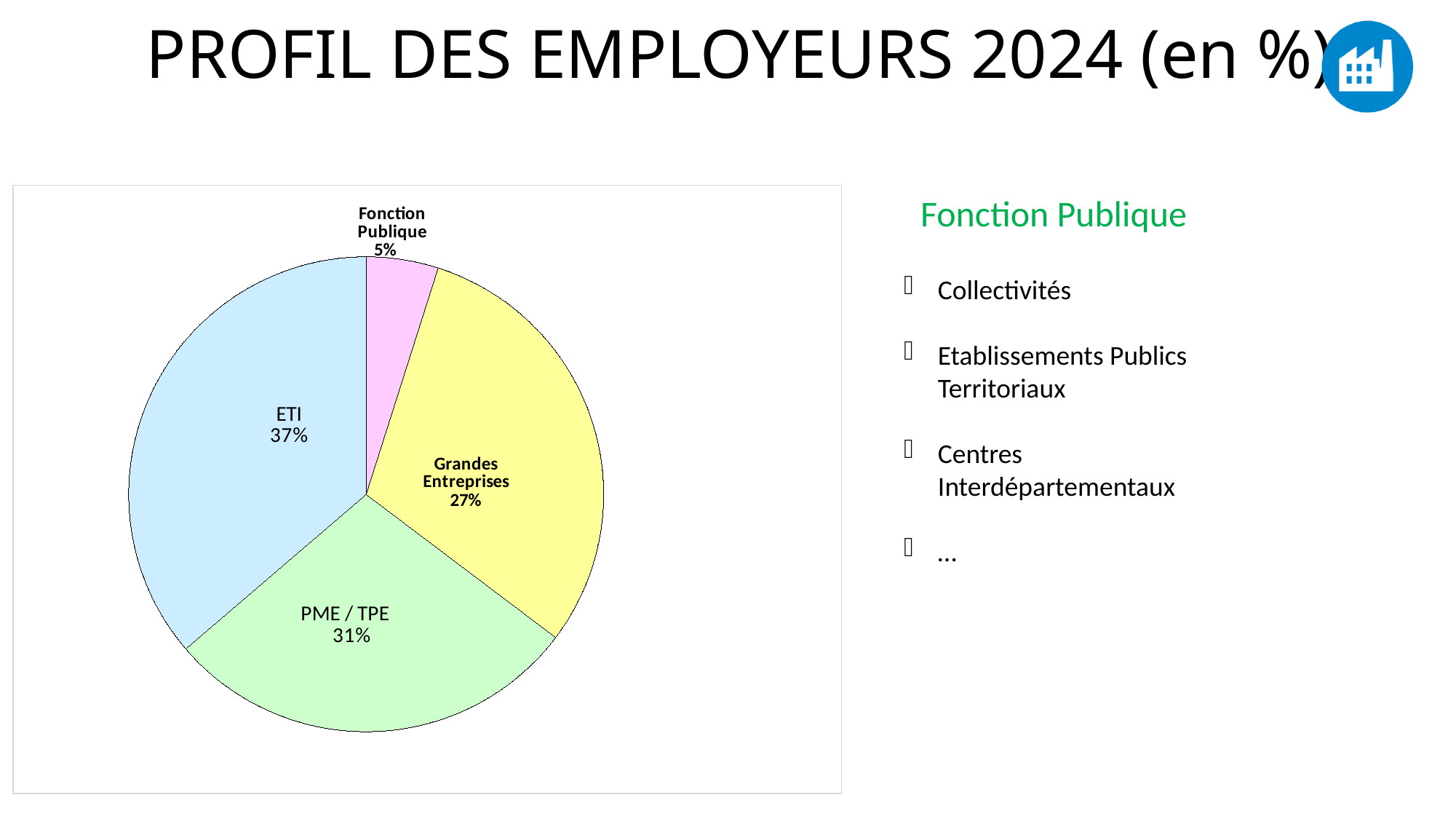
Which category has the largest slice of the pie? ETI How many slices does the pie chart have? 4 What is the difference in percentage points between Grandes Entreprises and Fonction Publique? 22 What share of the pie does PME / TPE represent? 31% What share of the pie does ETI represent? 37% What is the difference in percentage points between ETI and PME / TPE? 6 Which category has the smallest slice of the pie? Fonction Publique What colour is the ETI slice of the pie? Light blue What share of the pie does Grandes Entreprises represent? 27% Which is larger, the share for PME / TPE or the share for Grandes Entreprises? PME / TPE What share of the pie does Fonction Publique represent? 5% What kind of chart is shown on the slide? Pie chart